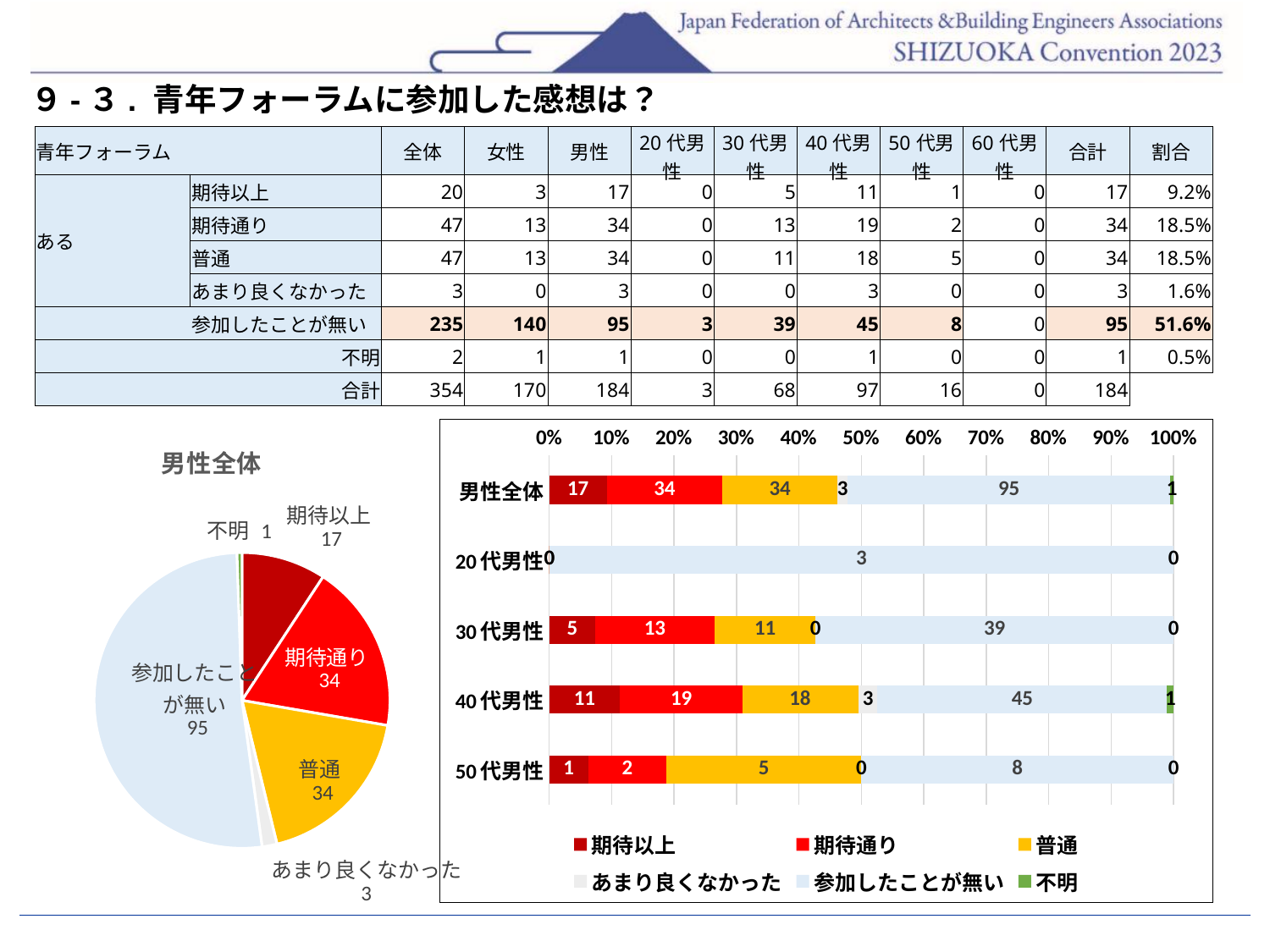
In the bar chart on the right, what is the value of 参加したことが無い for 30代男性? 39 In the pie chart titled 男性全体, which slice is the smallest? 不明 How many categories are plotted on the bar chart on the right? 5 In the bar chart on the right, what colour represents 期待以上 in the legend? Dark red In the pie chart titled 男性全体, which slice is the largest? 参加したことが無い In the bar chart on the right, what is the total of the stacked bar for 50代男性? 16 What kind of chart is the chart on the right of the slide? Stacked bar chart How many series does the legend of the bar chart on the right list? 6 In the bar chart on the right, what is the difference between 期待通り and 期待以上 for 男性全体? 17 In the pie chart titled 男性全体, what is the value for 普通? 34 In the bar chart on the right, what is the value of 期待通り for 40代男性? 19 In the bar chart on the right, which has the larger value for 普通: 30代男性 or 40代男性? 40代男性